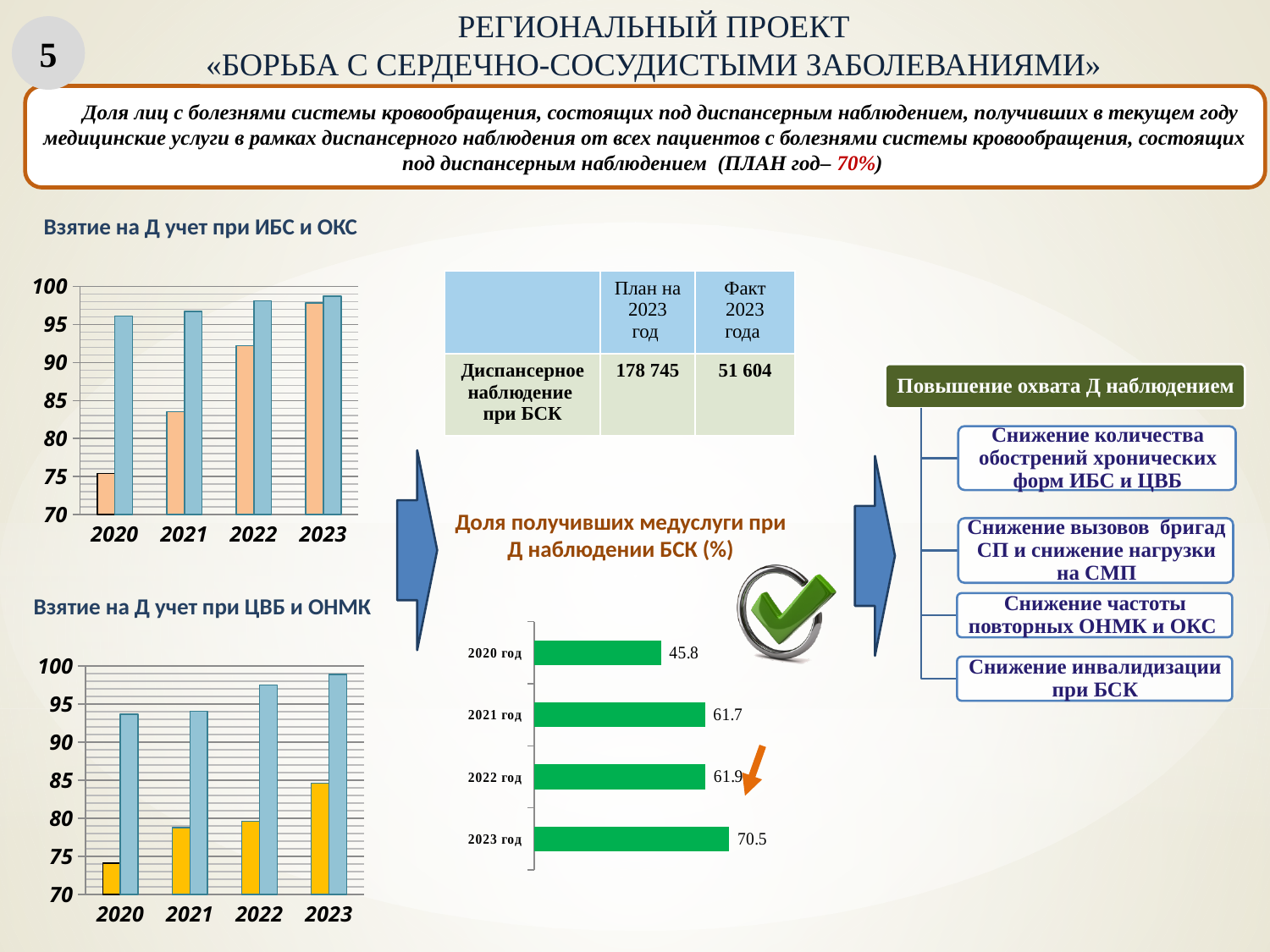
In the chart 'Доля получивших медуслуги при Д наблюдении БСК (%)', what is the value for 2023 год? 70.5 In the chart 'Доля получивших медуслуги при Д наблюдении БСК (%)', which year has the highest value? 2023 год In the chart 'Взятие на Д учет при ИБС и ОКС', is the value of the blue bar for 2020 greater or less than 90? greater How many years are shown in the chart 'Взятие на Д учет при ИБС и ОКС'? 4 What kind of chart is 'Доля получивших медуслуги при Д наблюдении БСК (%)'? bar chart In the chart 'Доля получивших медуслуги при Д наблюдении БСК (%)', what is the value for 2020 год? 45.8 In the chart 'Доля получивших медуслуги при Д наблюдении БСК (%)', do the values rise or fall from 2020 год to 2023 год? rise In the chart 'Взятие на Д учет при ИБС и ОКС', is the value of the orange bar for 2020 greater or less than 80? less In the chart 'Доля получивших медуслуги при Д наблюдении БСК (%)', what is the difference between the values for 2023 год and 2020 год? 24.7 In the chart 'Доля получивших медуслуги при Д наблюдении БСК (%)', what is the value for 2021 год? 61.7 In the chart 'Доля получивших медуслуги при Д наблюдении БСК (%)', which year has the lowest value? 2020 год In the chart 'Взятие на Д учет при ЦВБ и ОНМК', is the value of the yellow bar for 2023 greater or less than 90? less